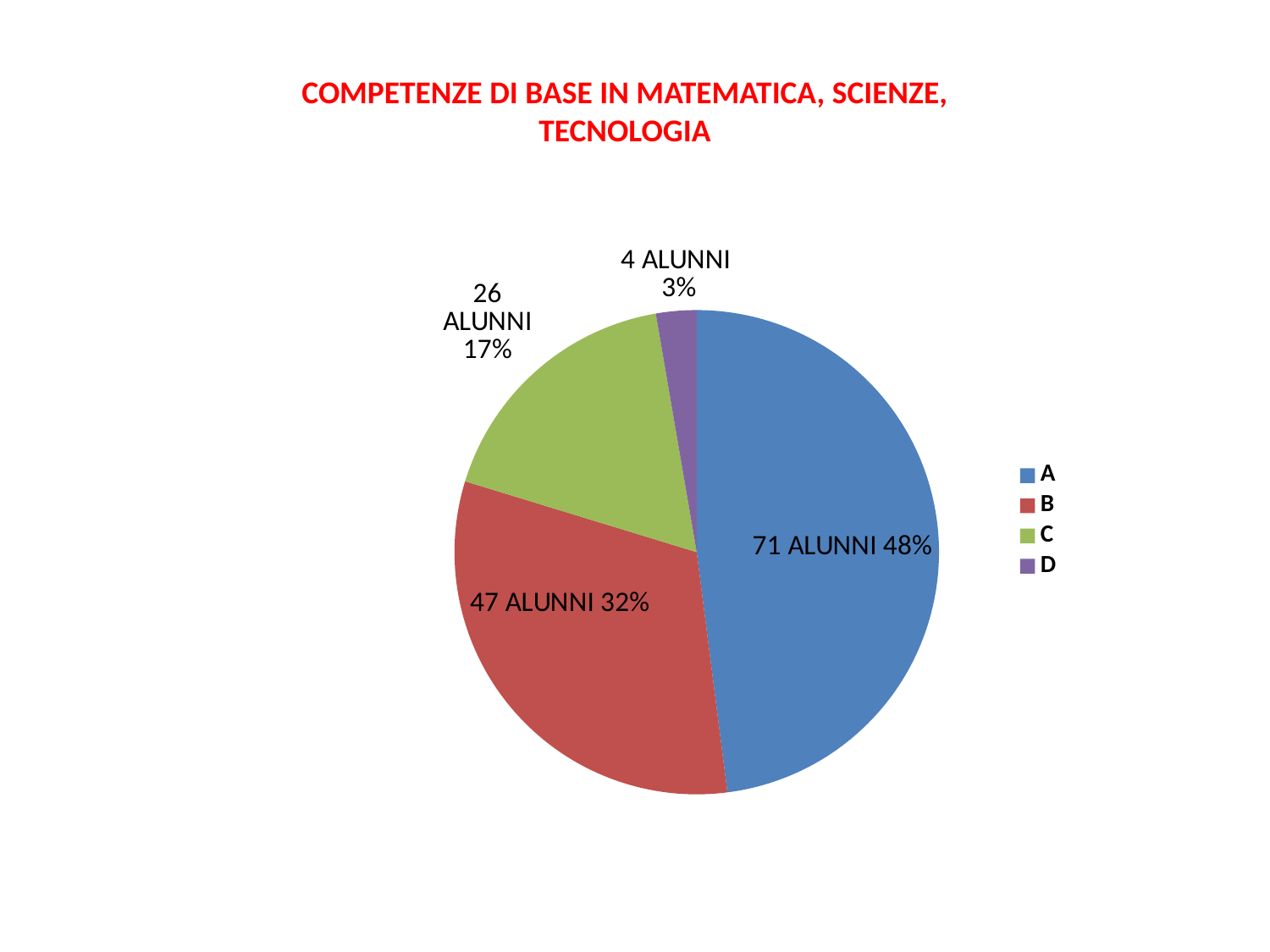
What percentage of the pie does category B represent? 32% Which category has more students, C or D? C How many students (alunni) are in category A? 71 ALUNNI What colour is the slice for category C? green How many students are in category C? 26 ALUNNI Which category has the largest slice of the pie? A Which category has the smallest slice of the pie? D How many categories does the pie chart have? 4 How many more students are in category A than in category B? 24 What is the title of the chart? COMPETENZE DI BASE IN MATEMATICA, SCIENZE, TECNOLOGIA What kind of chart is shown on the slide? pie chart What percentage of the pie does category D represent? 3%